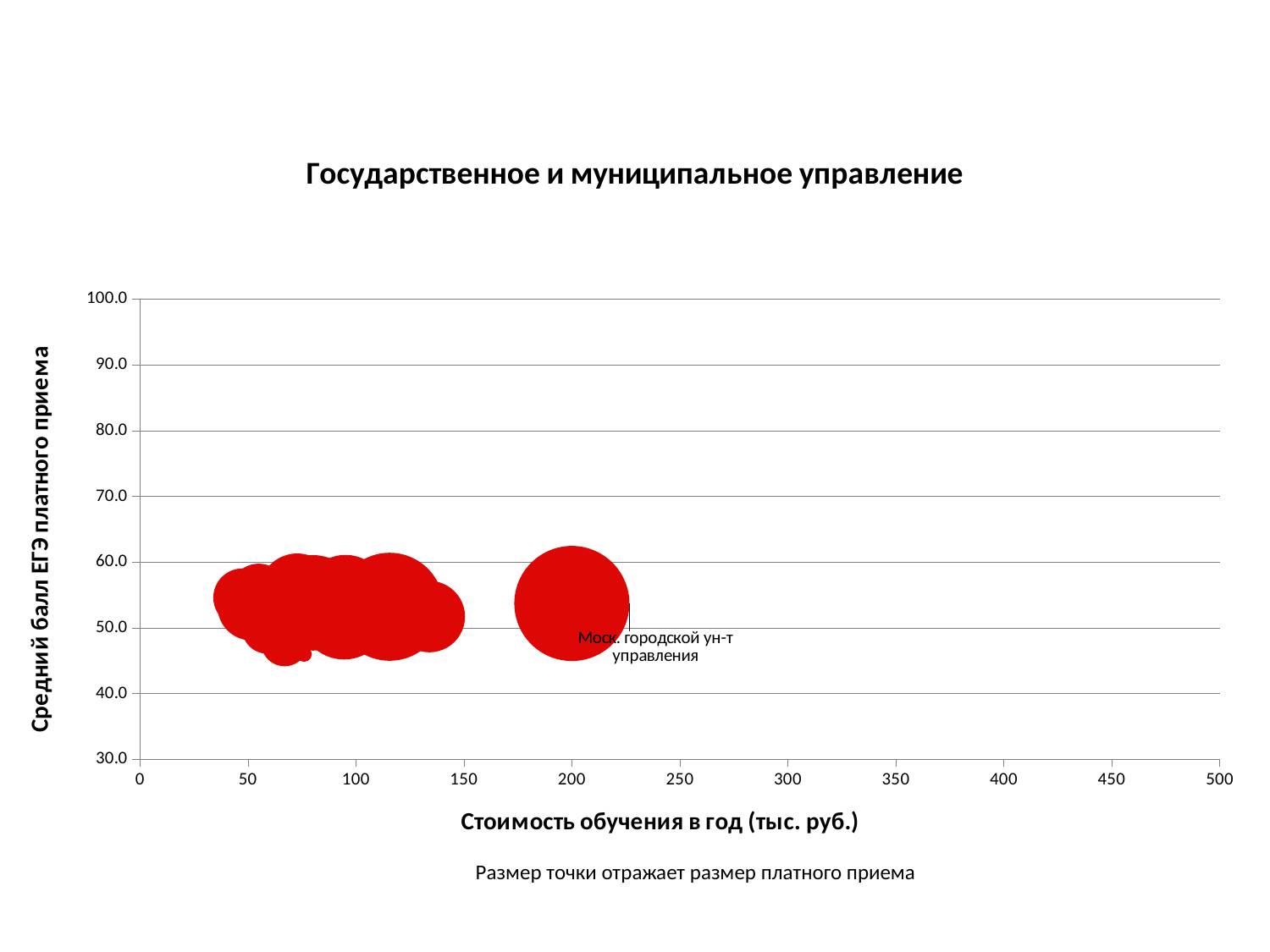
What is the label of the horizontal axis of the chart? Стоимость обучения в год (тыс. руб.) Which labeled institution has the highest tuition cost (rightmost bubble) on the chart? Моск. городской ун-т управления Is the average ЕГЭ score (y value) for Моск. городской ун-т управления greater or less than 40? greater What is the lowest value shown on the vertical axis of the chart? 30.0 What is the title of the chart? Государственное и муниципальное управление What kind of chart is shown on the slide? Bubble chart Is the tuition cost (x value) for Моск. городской ун-т управления greater or less than 300? less Is the tuition cost (x value) for Моск. городской ун-т управления greater or less than 150? greater